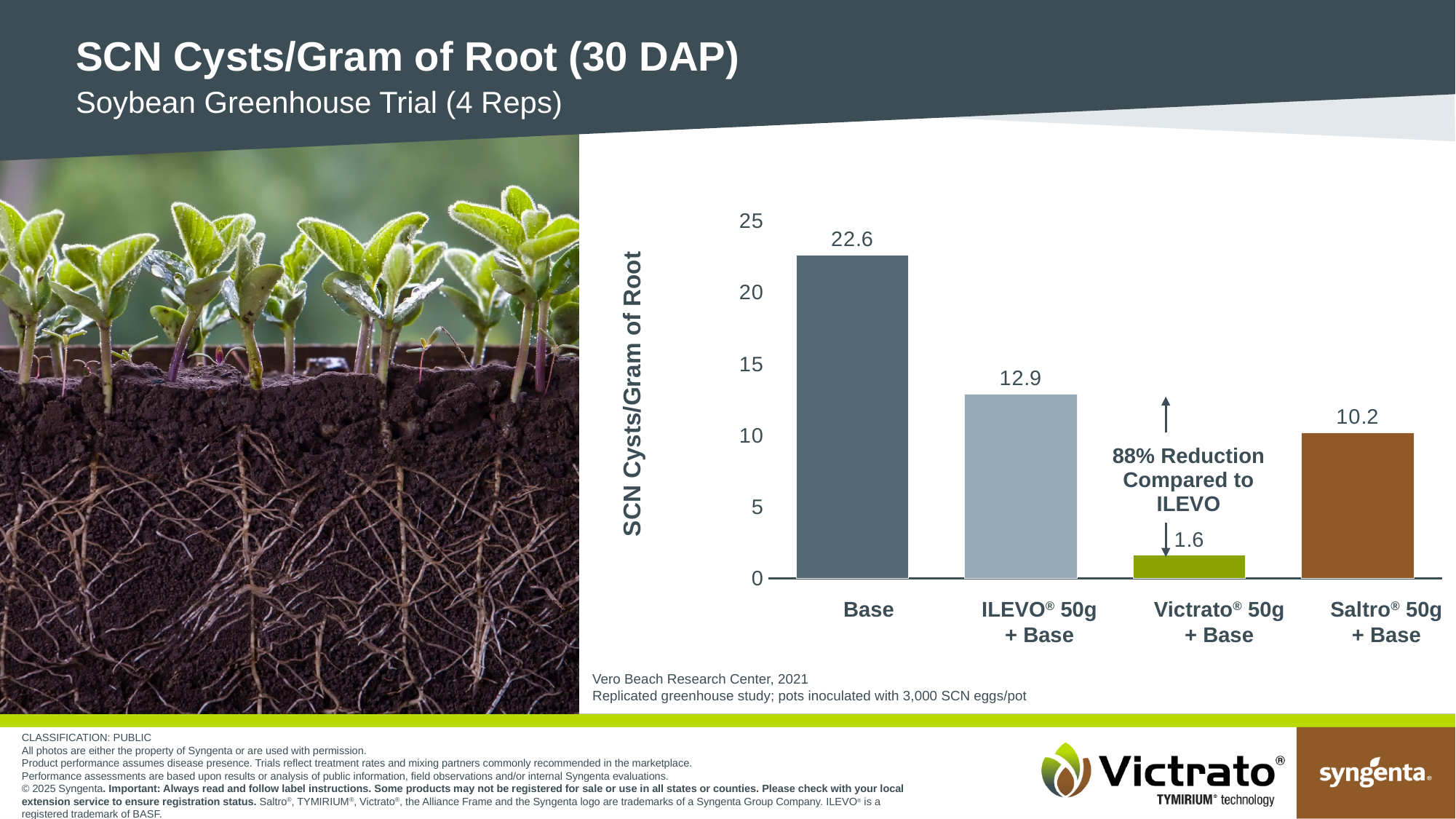
What is the value for Saltro 50g + Base? 10.2 What is the value for Victrato 50g + Base? 1.6 What percentage reduction compared to ILEVO is annotated on the chart? 88% What is the difference between ILEVO 50g + Base and Saltro 50g + Base? 2.7 What is the difference between the Base value and the Victrato 50g + Base value? 21.0 What is the value for ILEVO 50g + Base? 12.9 Which treatment has the lowest SCN cysts/gram of root? Victrato 50g + Base What kind of chart is shown on the slide? Bar chart What is the SCN cysts/gram of root value for the Base treatment? 22.6 Which is larger, the value for ILEVO 50g + Base or Saltro 50g + Base? ILEVO 50g + Base How many treatments are shown on the chart? 4 Which treatment has the highest SCN cysts/gram of root? Base